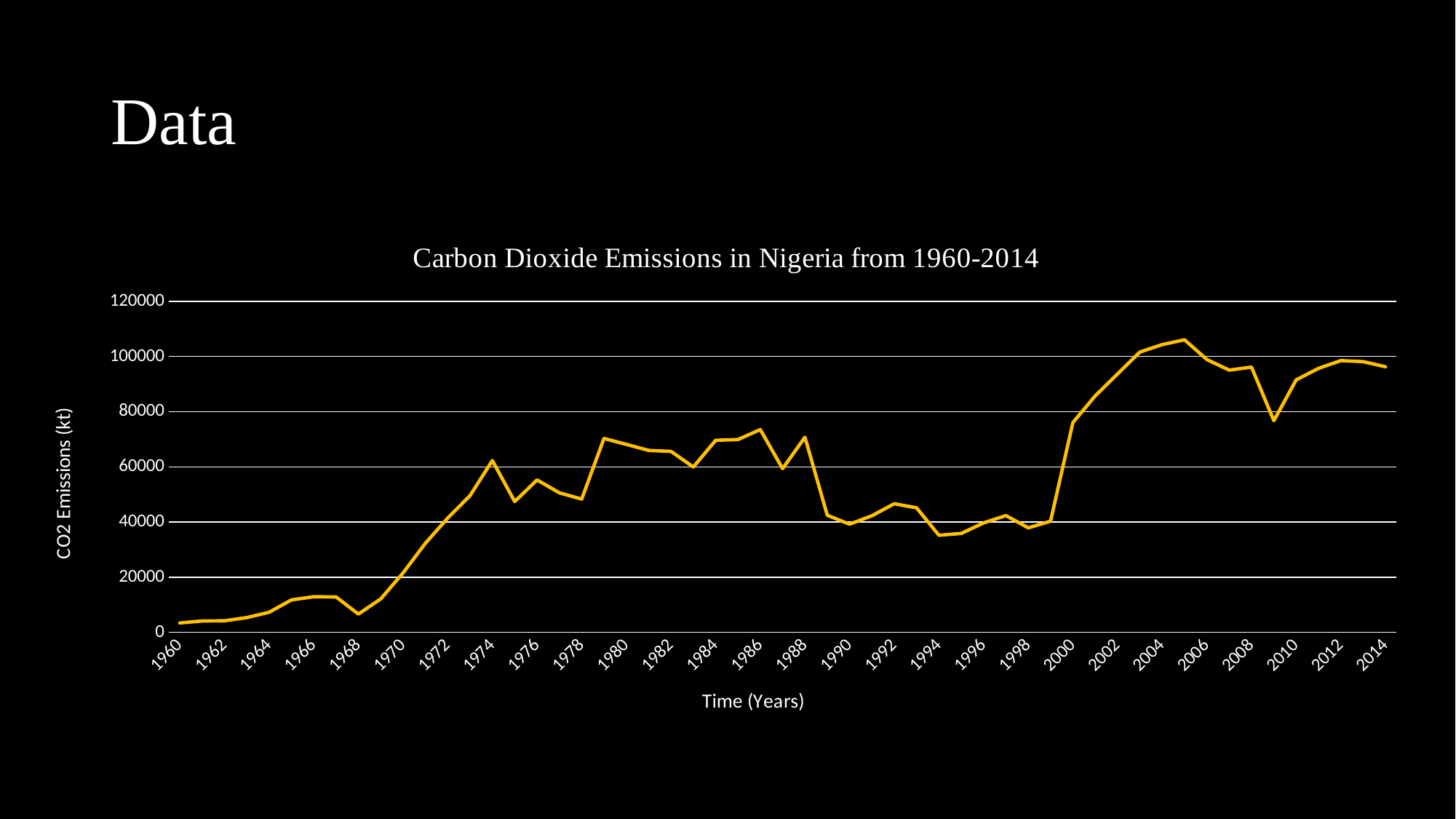
Is the value for 2000 greater or less than 60000? greater In which year do CO2 emissions reach their highest value? 2005 What is the title of the chart? Carbon Dioxide Emissions in Nigeria from 1960-2014 Is the value for 2005 greater or less than 100000? greater What kind of chart is shown on the slide? Line chart Which year has higher CO2 emissions, 1986 or 1994? 1986 Is the value for 1960 greater or less than 20000? less In which year are CO2 emissions lowest? 1960 What is the label of the vertical axis? CO2 Emissions (kt) Do CO2 emissions rise or fall between 1988 and 1994? Fall Do CO2 emissions rise or fall between 1960 and 1974? Rise